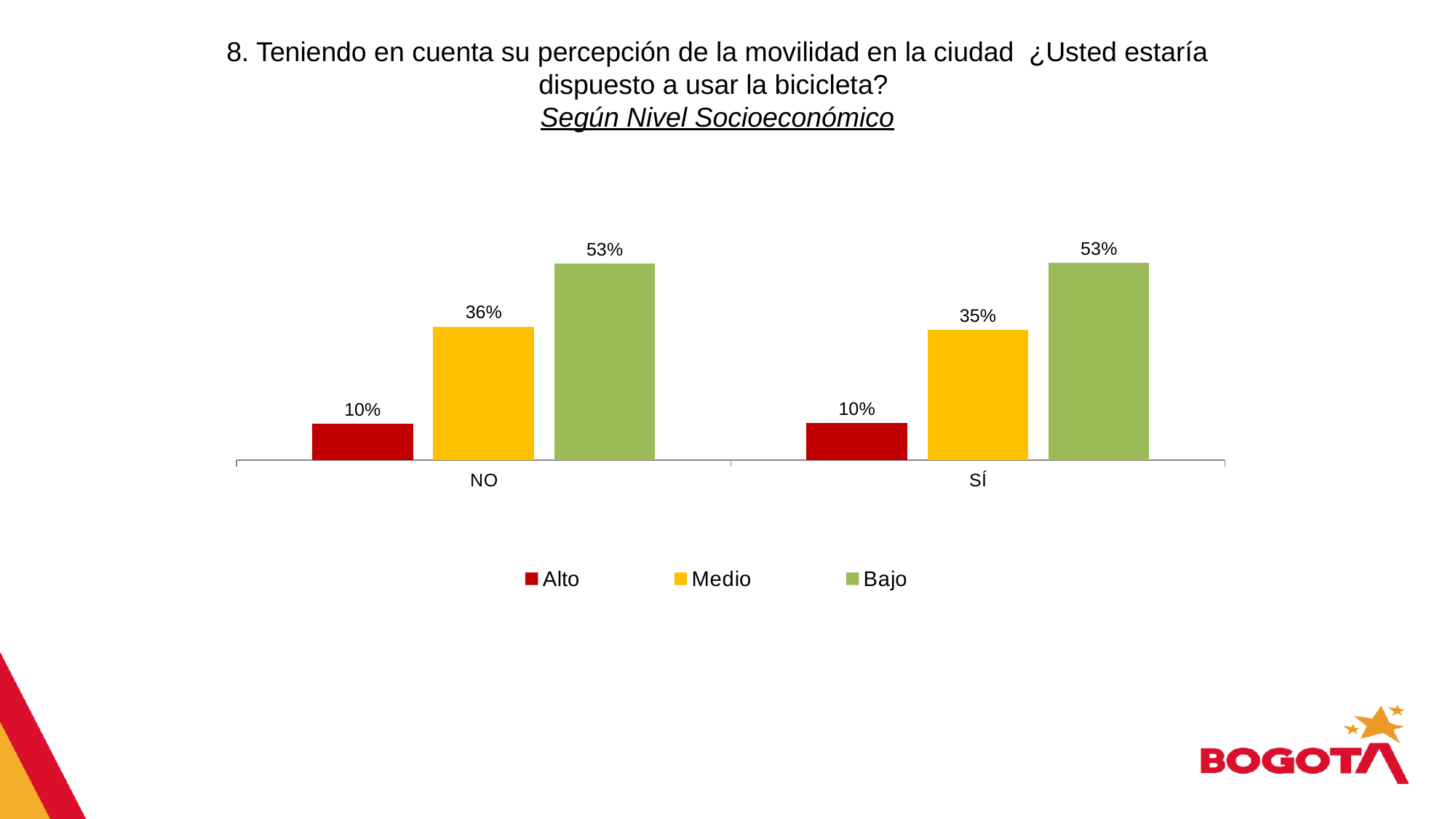
Which is larger: Medio in NO or Alto in SÍ? Medio in NO Which series has the lowest value in the NO category? Alto What is the difference between the Medio values for NO and SÍ? 1% How many categories are shown on the x axis? 2 Which series has the highest value in the SÍ category? Bajo What is the value for Medio in the SÍ category? 35% What is the value for Alto in the NO category? 10% How many series does the legend list? 3 What is the value for Medio in the NO category? 36% What kind of chart is shown on the slide? Bar chart What is the difference between the Bajo and Alto values in the SÍ category? 43% What is the value for Bajo in the NO category? 53%